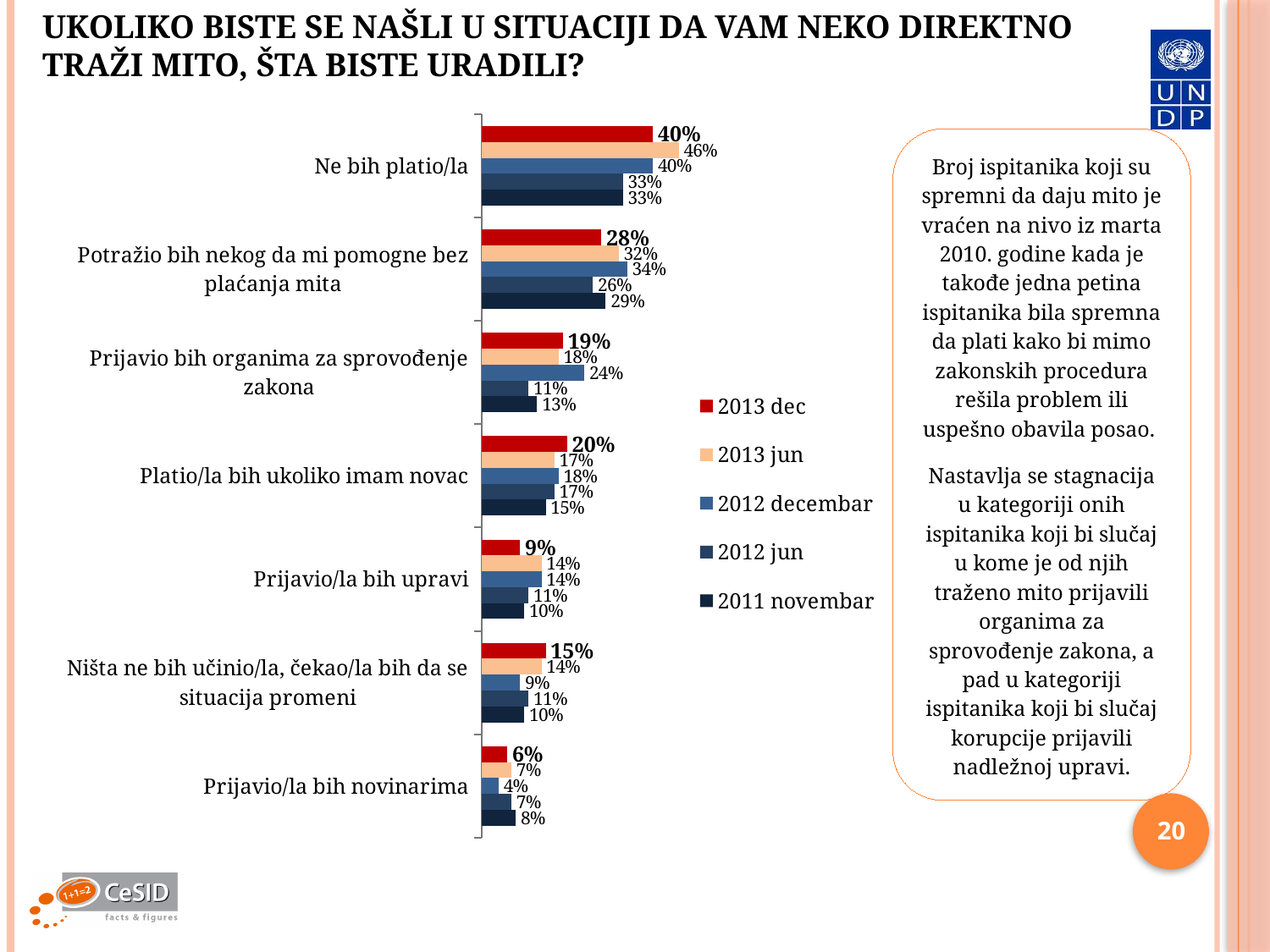
How many response categories are shown on the chart? 7 What is the difference between the 2013 jun and 2013 dec values for "Ne bih platio/la"? 6% What is the value for "Prijavio bih organima za sprovođenje zakona" in the 2012 decembar series? 24% What is the value for "Prijavio/la bih novinarima" in the 2013 dec series? 6% What is the value for "Platio/la bih ukoliko imam novac" in the 2011 novembar series? 15% How many series does the legend list? 5 What kind of chart is shown on the slide? bar chart What is the value for "Ne bih platio/la" in the 2013 jun series? 46% Which series is shown in red in the legend? 2013 dec For "Prijavio/la bih upravi", which is larger: the 2013 jun value or the 2013 dec value? 2013 jun Which category has the lowest value in the 2012 decembar series? Prijavio/la bih novinarima Which category has the highest value in the 2013 dec series? Ne bih platio/la